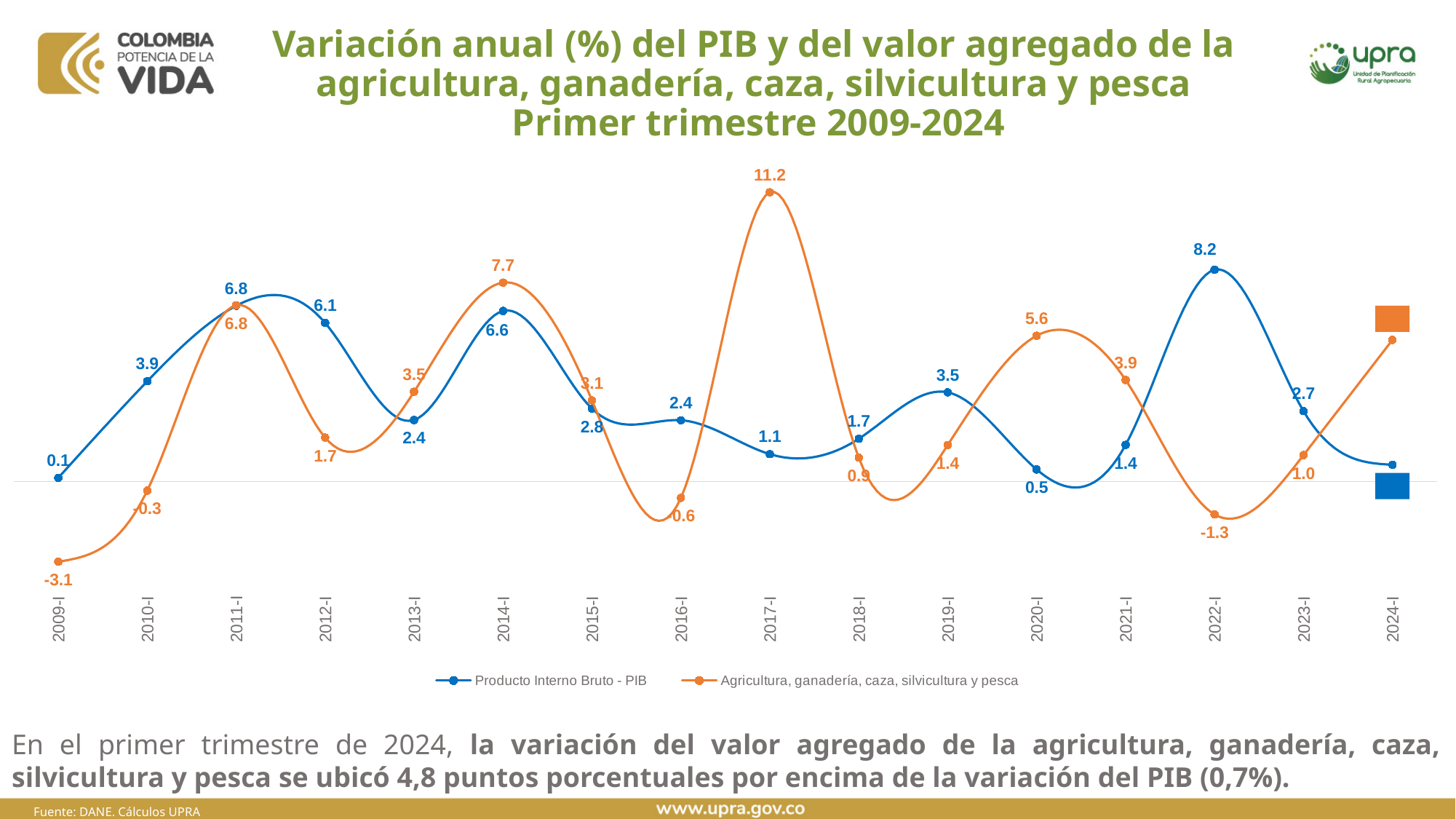
In 2014-I, how much higher is the Agricultura, ganadería, caza, silvicultura y pesca value than the Producto Interno Bruto - PIB value? 1.1 How many series does the legend list? 2 What kind of chart is shown on the slide? Line chart By how much did the Producto Interno Bruto - PIB value fall from 2022-I to 2023-I? 5.5 What is the value of Agricultura, ganadería, caza, silvicultura y pesca for 2017-I? 11.2 In 2020-I, which series has the larger value, Producto Interno Bruto - PIB or Agricultura, ganadería, caza, silvicultura y pesca? Agricultura, ganadería, caza, silvicultura y pesca In which period does the Agricultura, ganadería, caza, silvicultura y pesca series reach its highest value? 2017-I In which period does the Producto Interno Bruto - PIB series reach its highest value? 2022-I What is the value of Producto Interno Bruto - PIB for 2009-I? 0.1 How many periods are shown on the x axis of the chart? 16 What is the value of Producto Interno Bruto - PIB for 2022-I? 8.2 In which period does the Agricultura, ganadería, caza, silvicultura y pesca series reach its lowest value? 2009-I